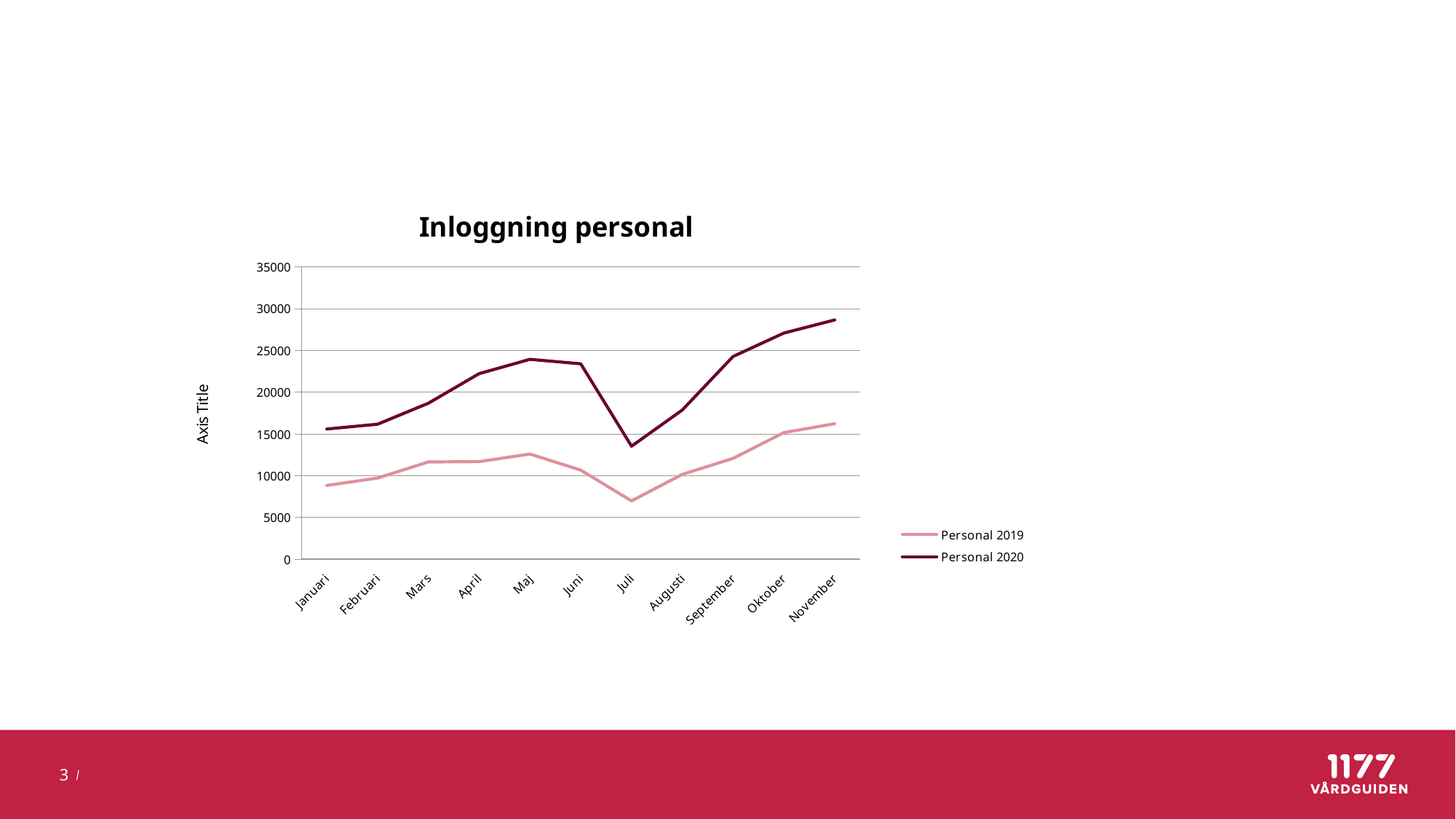
How many months are shown along the x axis? 11 What kind of chart is shown on the slide? line chart Is the value for Personal 2020 in Maj greater or less than 20000? greater In which month is the Personal 2019 series at its lowest? Juli What is the title of the chart? Inloggning personal Does the Personal 2020 series rise or fall from Juli to November? rise How many series does the legend list? 2 In which month is the Personal 2020 series at its highest? November Which series has the larger value in Januari, Personal 2019 or Personal 2020? Personal 2020 In which month is the Personal 2020 series at its lowest? Juli Is the value for Personal 2020 in November greater or less than 25000? greater Is the value for Personal 2019 in Juli greater or less than 10000? less